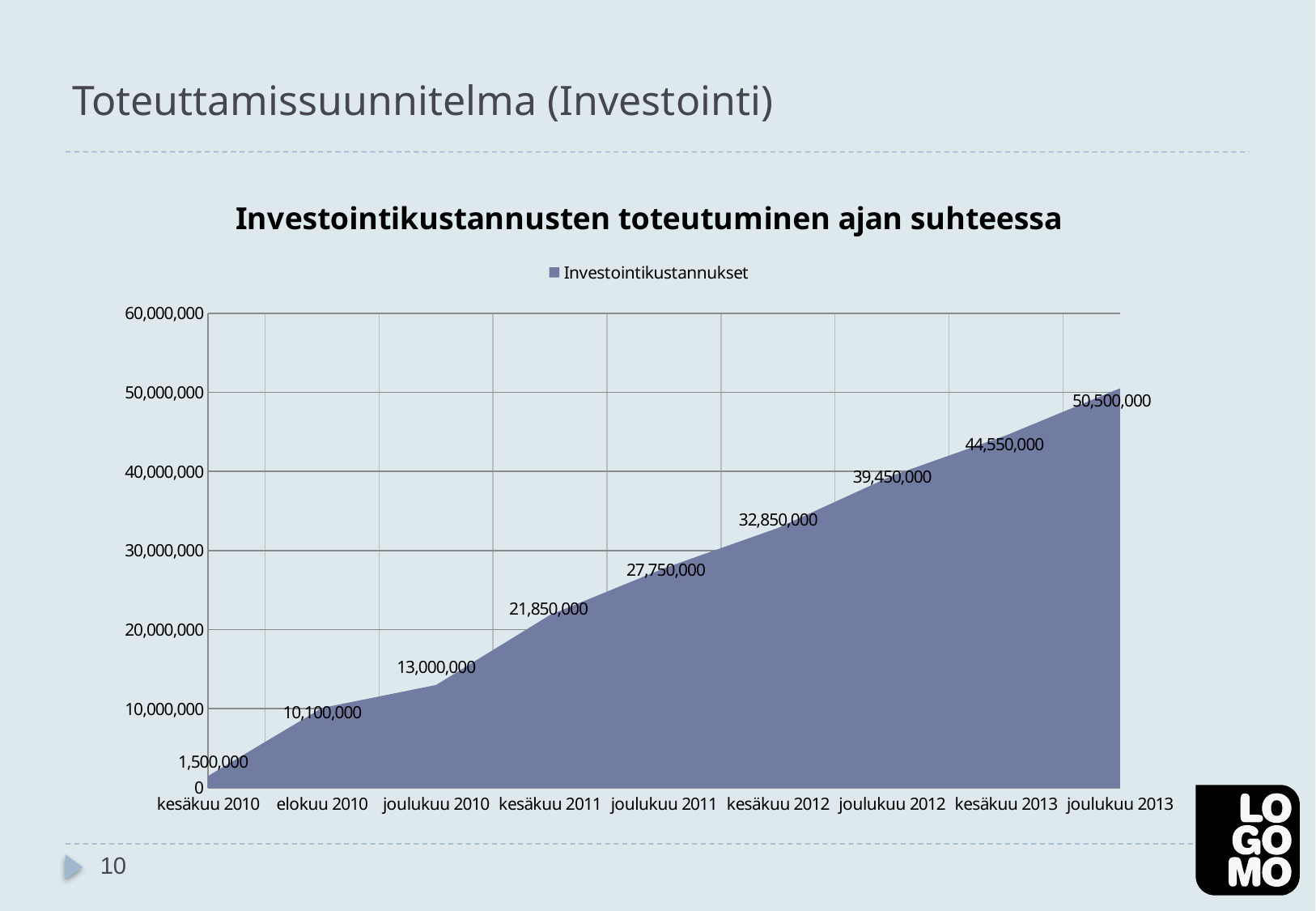
What is the value for joulukuu 2011? 27,750,000 How many series does the legend list? 1 What is the difference between the values for joulukuu 2010 and elokuu 2010? 2,900,000 What is the value for kesäkuu 2010? 1,500,000 What is the value for kesäkuu 2013? 44,550,000 Which category has the lowest value? kesäkuu 2010 What is the difference between the values for joulukuu 2013 and kesäkuu 2013? 5,950,000 Which is larger, the value for kesäkuu 2012 or the value for joulukuu 2011? kesäkuu 2012 What is the title of the chart? Investointikustannusten toteutuminen ajan suhteessa How many categories are shown on the x axis? 9 Which category has the highest value? joulukuu 2013 Do the values rise or fall from kesäkuu 2010 to joulukuu 2013? rise